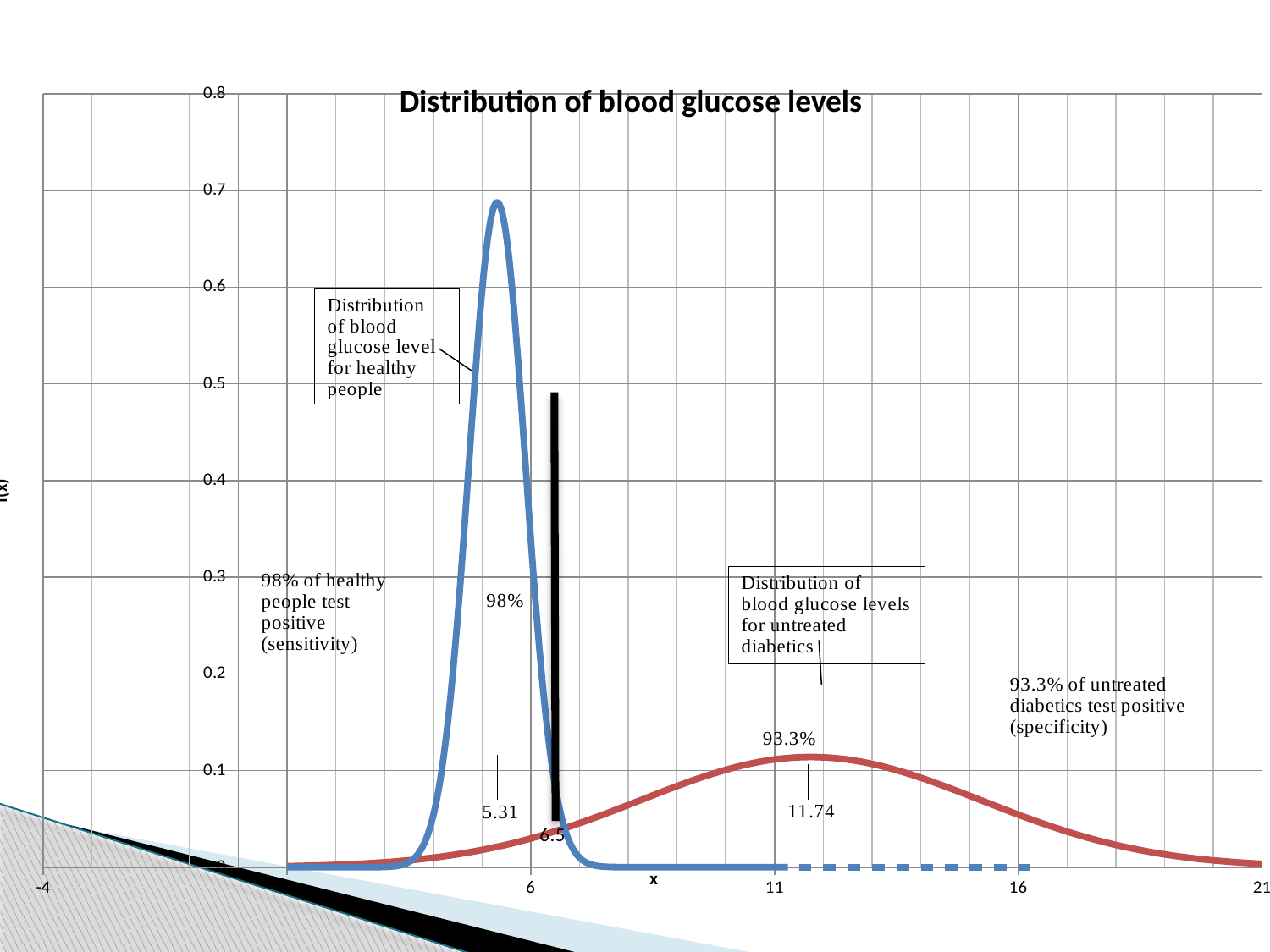
How many distribution curves are plotted on the chart? 2 What percentage of untreated diabetics test positive (specificity) according to the chart? 93.3% What x value is marked by the vertical black line between the two curves? 6.5 What colour is the curve for the distribution of blood glucose levels for untreated diabetics? red What is the title of the chart? Distribution of blood glucose levels What percentage of healthy people test positive (sensitivity) according to the chart? 98% Is the peak value of the distribution for untreated diabetics greater or less than 0.2? less What x value is labelled at the peak of the distribution for untreated diabetics? 11.74 What x value is labelled at the peak of the distribution for healthy people? 5.31 What kind of chart is shown on the slide? line chart Which distribution has the higher peak, healthy people or untreated diabetics? healthy people Is the peak value of the distribution for healthy people greater or less than 0.6? greater